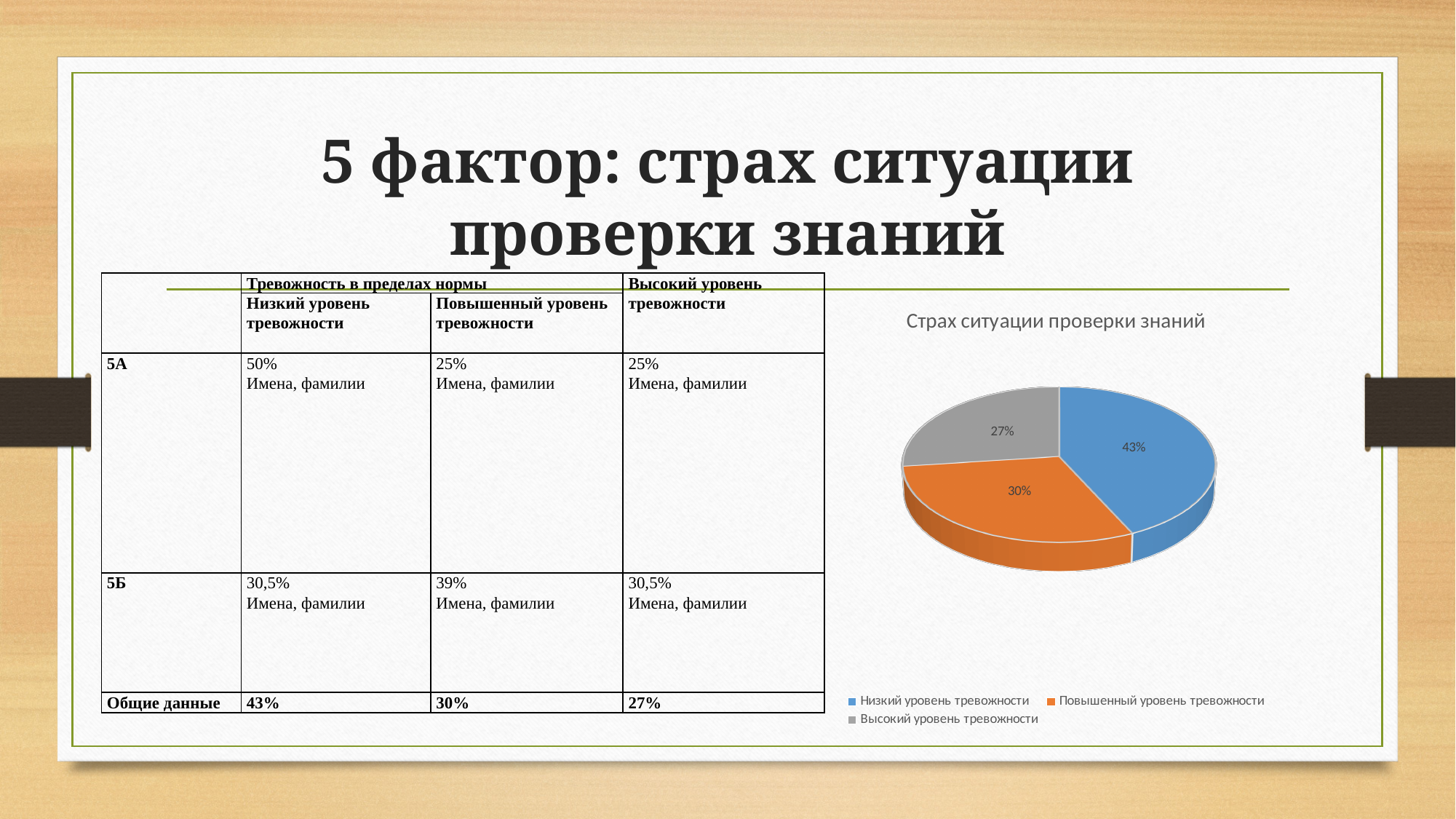
What share of the pie is labelled Высокий уровень тревожности? 27% How many entries does the chart legend list? 3 What type of chart is shown on the slide? Pie chart What is the difference in percentage points between the Низкий уровень тревожности slice and the Высокий уровень тревожности slice? 16 What share of the pie is labelled Низкий уровень тревожности? 43% What share of the pie is labelled Повышенный уровень тревожности? 30% Which category has the smallest slice of the pie? Высокий уровень тревожности Which slice is larger: Повышенный уровень тревожности or Высокий уровень тревожности? Повышенный уровень тревожности What is the title of the chart? Страх ситуации проверки знаний What colour is the slice for Повышенный уровень тревожности? Orange Which category has the largest slice of the pie? Низкий уровень тревожности How many slices does the pie chart have? 3